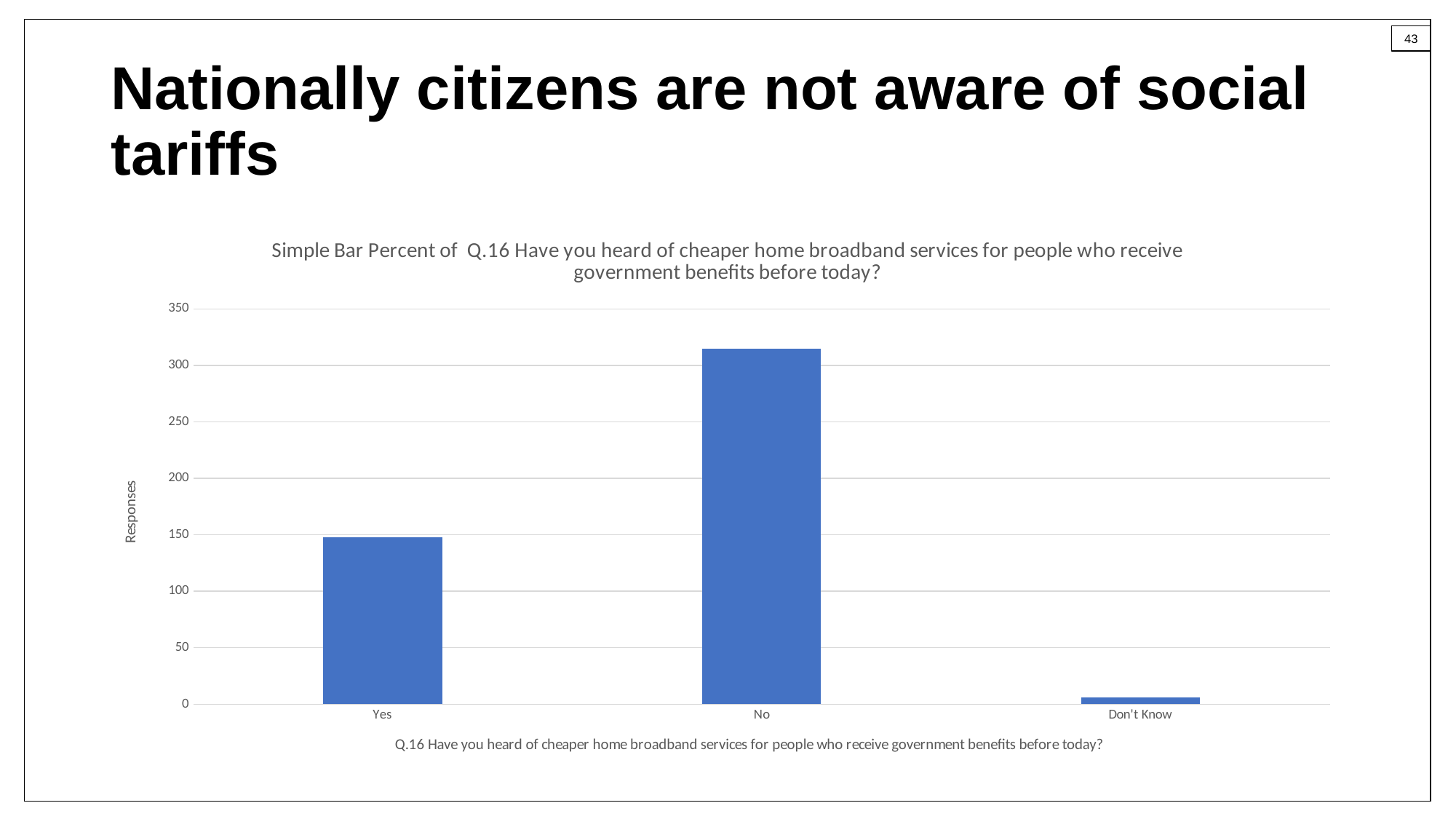
Is the value for Don't Know greater or less than 50? less Is the value for No greater or less than 300? greater What kind of chart is shown on the slide? Bar chart Which has more responses, Yes or No? No Which has more responses, Yes or Don't Know? Yes How many categories are shown on the x axis? 3 What is the highest value shown on the y axis? 350 Which category has the highest number of responses? No Which category has the lowest number of responses? Don't Know What is the label of the y axis? Responses